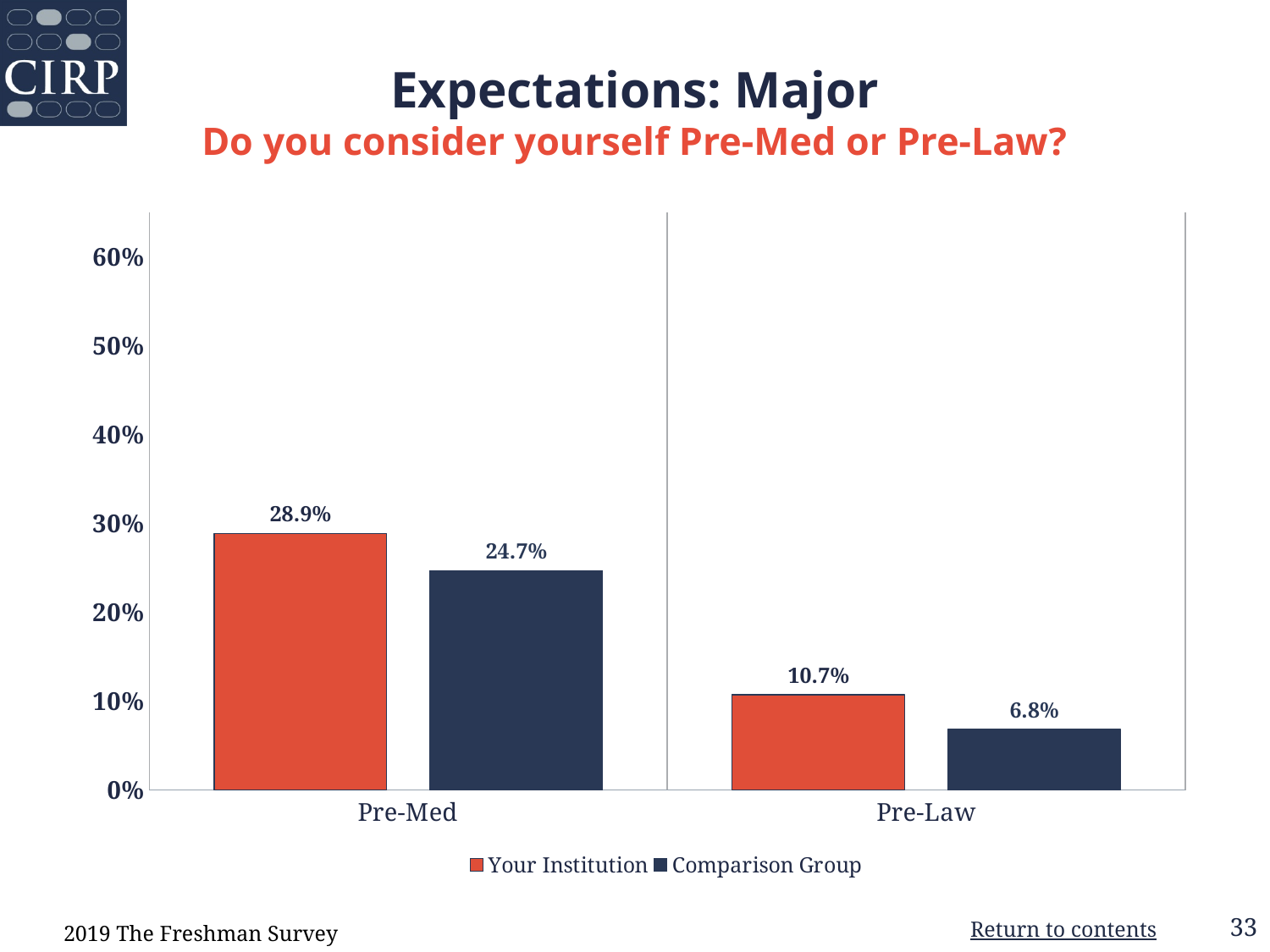
For Pre-Law, which is larger: Your Institution or the Comparison Group? Your Institution Which bar has the lowest value on the chart? Comparison Group, Pre-Law What kind of chart is shown on the slide? Bar chart What is the difference between Your Institution and the Comparison Group for Pre-Med? 4.2% What is the Comparison Group value for Pre-Med? 24.7% What is the Comparison Group value for Pre-Law? 6.8% What is the Your Institution value for Pre-Law? 10.7% Which bar has the highest value on the chart? Your Institution, Pre-Med How many series does the legend list? 2 What percentage of students at Your Institution consider themselves Pre-Med? 28.9% What is the difference between Your Institution and the Comparison Group for Pre-Law? 3.9% How many categories are shown on the x axis? 2